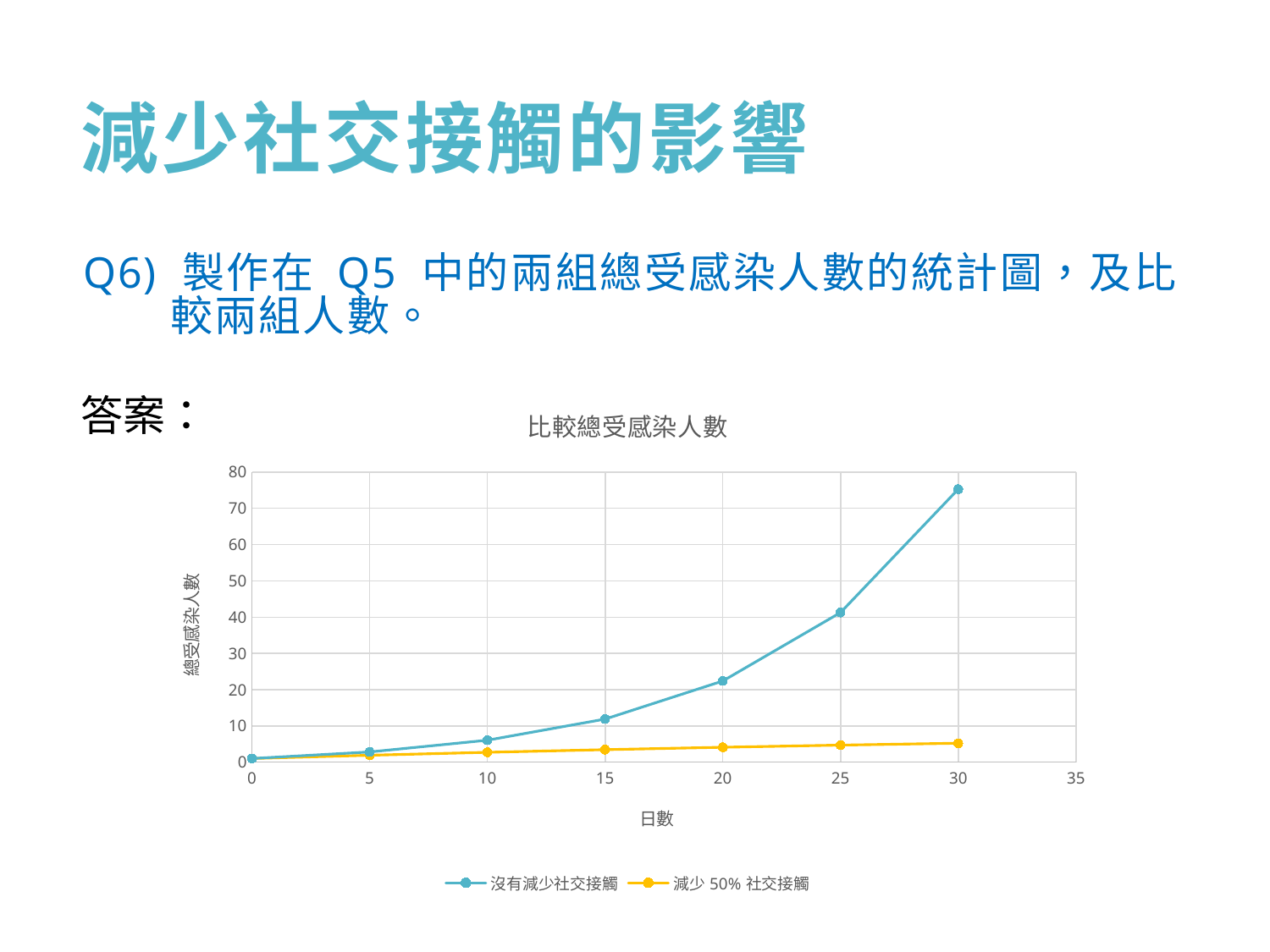
Is the value for 沒有減少社交接觸 at day 30 greater or less than 70? greater At day 30, which series has the larger value, 沒有減少社交接觸 or 減少 50% 社交接觸? 沒有減少社交接觸 Is the value for 減少 50% 社交接觸 at day 30 greater or less than 10? less Is the value for 沒有減少社交接觸 at day 20 greater or less than 30? less What kind of chart is shown under the title 比較總受感染人數? line chart How many series does the legend of the chart list? 2 Does the 沒有減少社交接觸 series rise or fall as 日數 increases? rise What is the label of the vertical axis of the chart? 總受感染人數 How many data points are plotted for the 沒有減少社交接觸 series? 7 At which day does the 沒有減少社交接觸 series reach its highest value? 30 What are the two series named in the chart legend? 沒有減少社交接觸 and 減少 50% 社交接觸